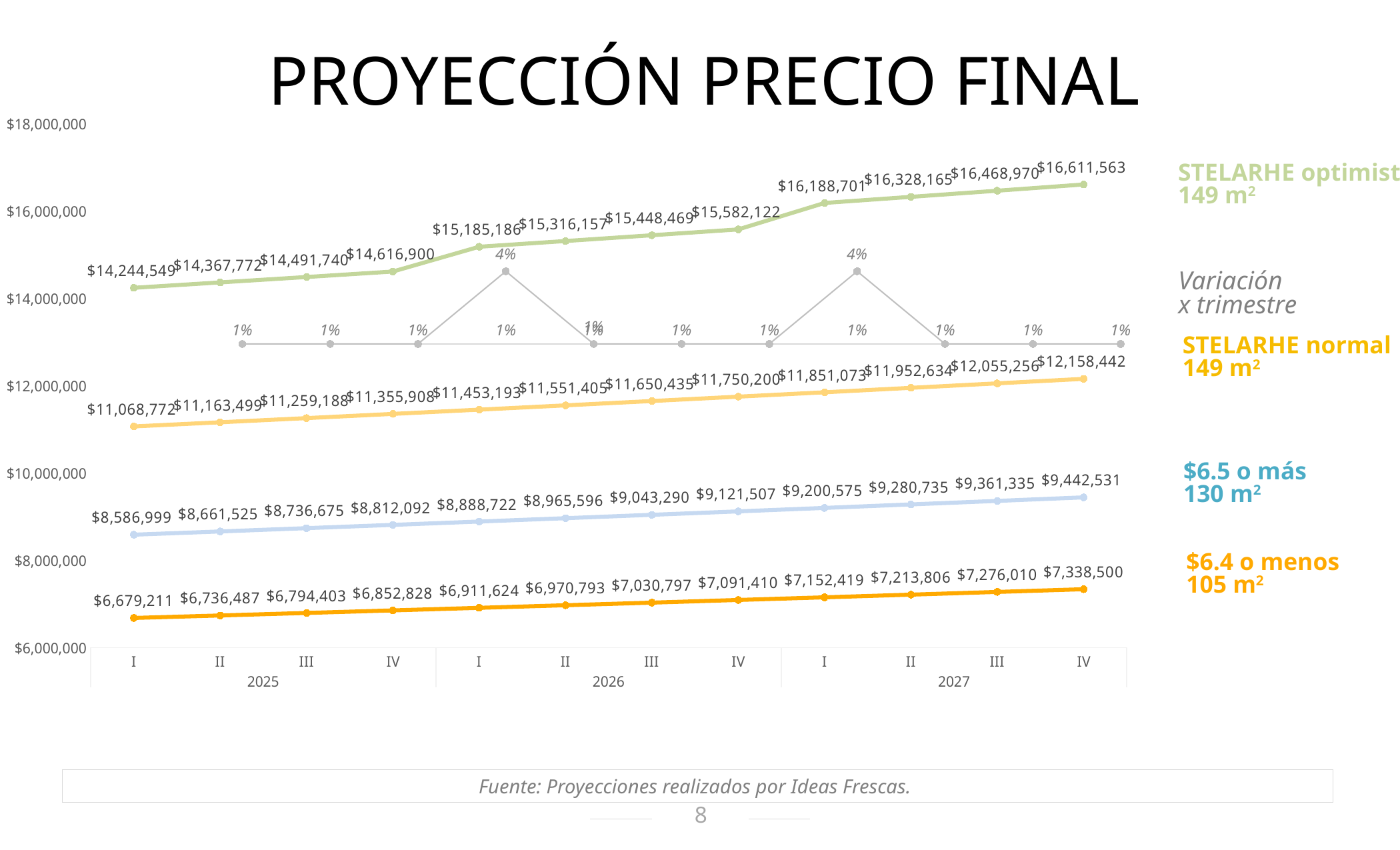
How many quarters are plotted along the x axis? 12 What is the projected price for STELARHE normal 149 m² in quarter I of 2025? $11,068,772 What is the projected price for STELARHE optimist 149 m² in quarter IV of 2027? $16,611,563 What is the projected price for the $6.5 o más 130 m² series in quarter III of 2027? $9,361,335 How much higher is the STELARHE optimist price than the STELARHE normal price in quarter IV of 2027? $4,453,121 What is the projected price for the $6.4 o menos 105 m² series in quarter II of 2026? $6,970,793 What quarterly variation is shown for quarter I of 2026 on the Variación x trimestre line? 4% By how much does the STELARHE normal 149 m² price increase from quarter I of 2025 to quarter IV of 2027? $1,089,670 Which series has the highest projected price in quarter IV of 2027? STELARHE optimist 149 m² What kind of chart is shown on the slide? Line chart Which series has the lowest projected price in quarter I of 2025? $6.4 o menos 105 m² Do the projected prices rise or fall from 2025 to 2027? Rise